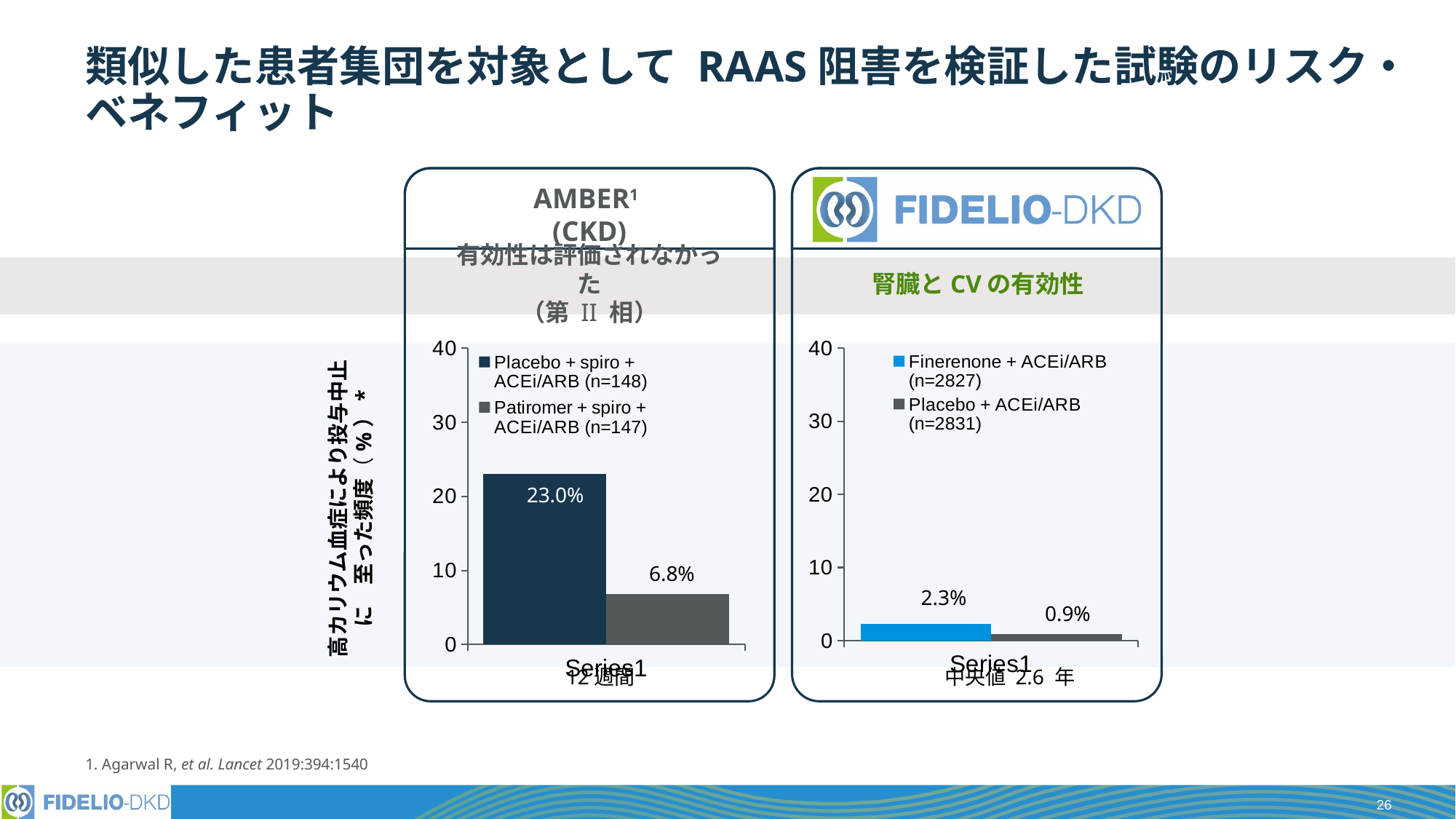
In the FIDELIO-DKD chart on the right, what is the value for Finerenone + ACEi/ARB (n=2827)? 2.3% In the AMBER (CKD) chart on the left, which series has the higher value? Placebo + spiro + ACEi/ARB (n=148) In the AMBER (CKD) chart on the left, what is the value for Placebo + spiro + ACEi/ARB (n=148)? 23.0% In the AMBER (CKD) chart on the left, is the value for Placebo + spiro + ACEi/ARB greater or less than 20? greater In the FIDELIO-DKD chart on the right, what is the difference between the Finerenone + ACEi/ARB value and the Placebo + ACEi/ARB value? 1.4% In the AMBER (CKD) chart on the left, what is the difference between the Placebo + spiro + ACEi/ARB value and the Patiromer + spiro + ACEi/ARB value? 16.2% In the FIDELIO-DKD chart on the right, which series has the lower value? Placebo + ACEi/ARB (n=2831) What kind of chart is the AMBER (CKD) chart on the left? bar chart In the AMBER (CKD) chart on the left, what is the value for Patiromer + spiro + ACEi/ARB (n=147)? 6.8% In the FIDELIO-DKD chart on the right, what is the value for Placebo + ACEi/ARB (n=2831)? 0.9% How many series does the legend of the FIDELIO-DKD chart on the right list? 2 What is the maximum value shown on the y axis of the FIDELIO-DKD chart on the right? 40